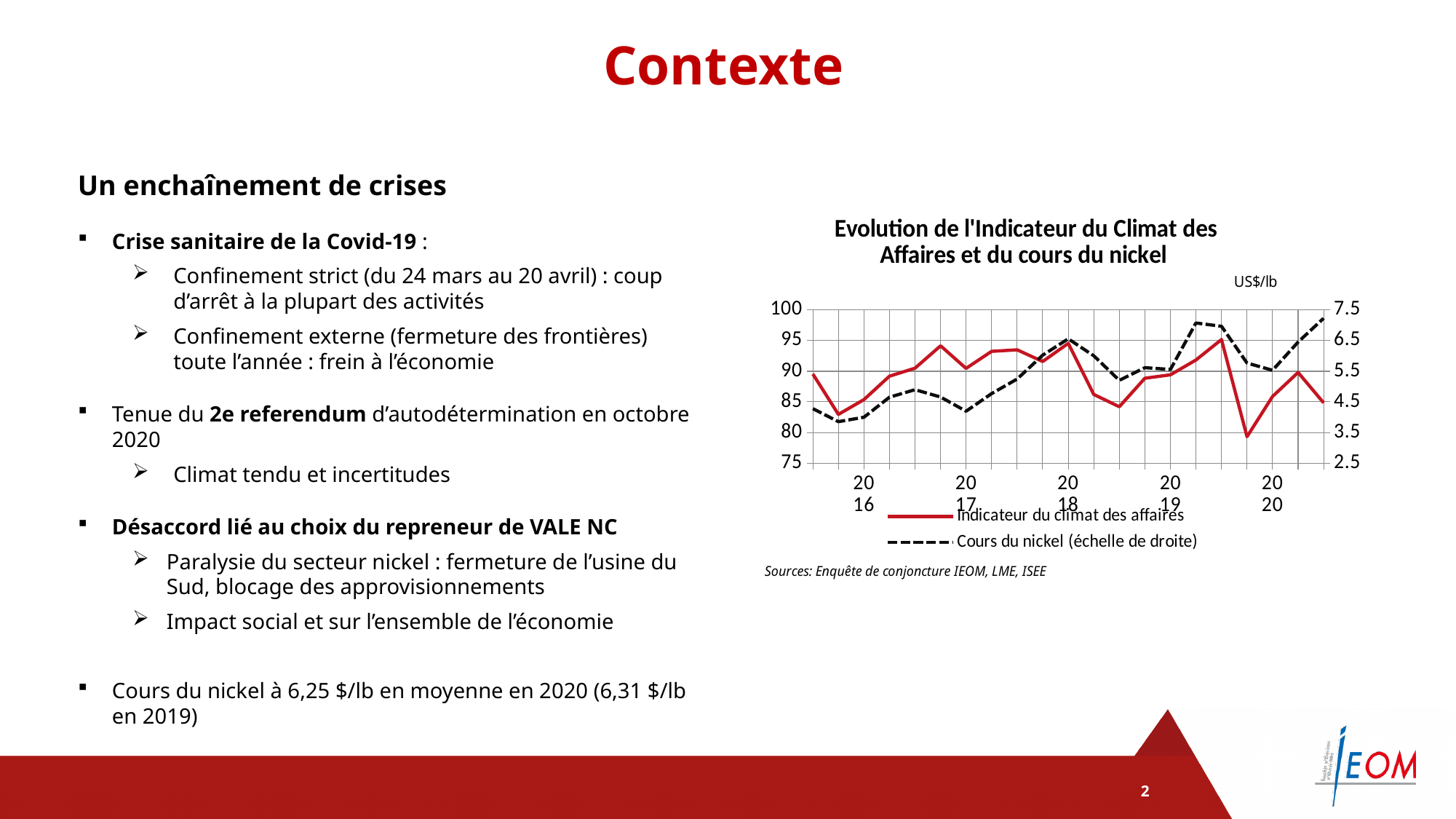
Is the value of the 'Cours du nickel' line at the end of 2020 greater or less than 6.5? greater What is the highest tick value shown on the left axis of the chart? 100 What kind of chart is shown on the slide? Line chart Overall, does the 'Cours du nickel' line rise or fall between 2016 and the end of 2020? Rise How many series does the chart legend list? 2 In which year does the 'Cours du nickel' line reach its lowest point? 2016 How many year labels appear on the x axis of the chart? 5 In which year does the 'Indicateur du climat des affaires' line reach its lowest point? 2020 Which series is plotted on the right-hand axis according to the legend? Cours du nickel (échelle de droite) Is the value of the 'Cours du nickel' line at the start of 2016 greater or less than 4.5? less Is the lowest value of the 'Indicateur du climat des affaires' line, in 2020, greater or less than 85? less What is the title of the chart? Evolution de l'Indicateur du Climat des Affaires et du cours du nickel